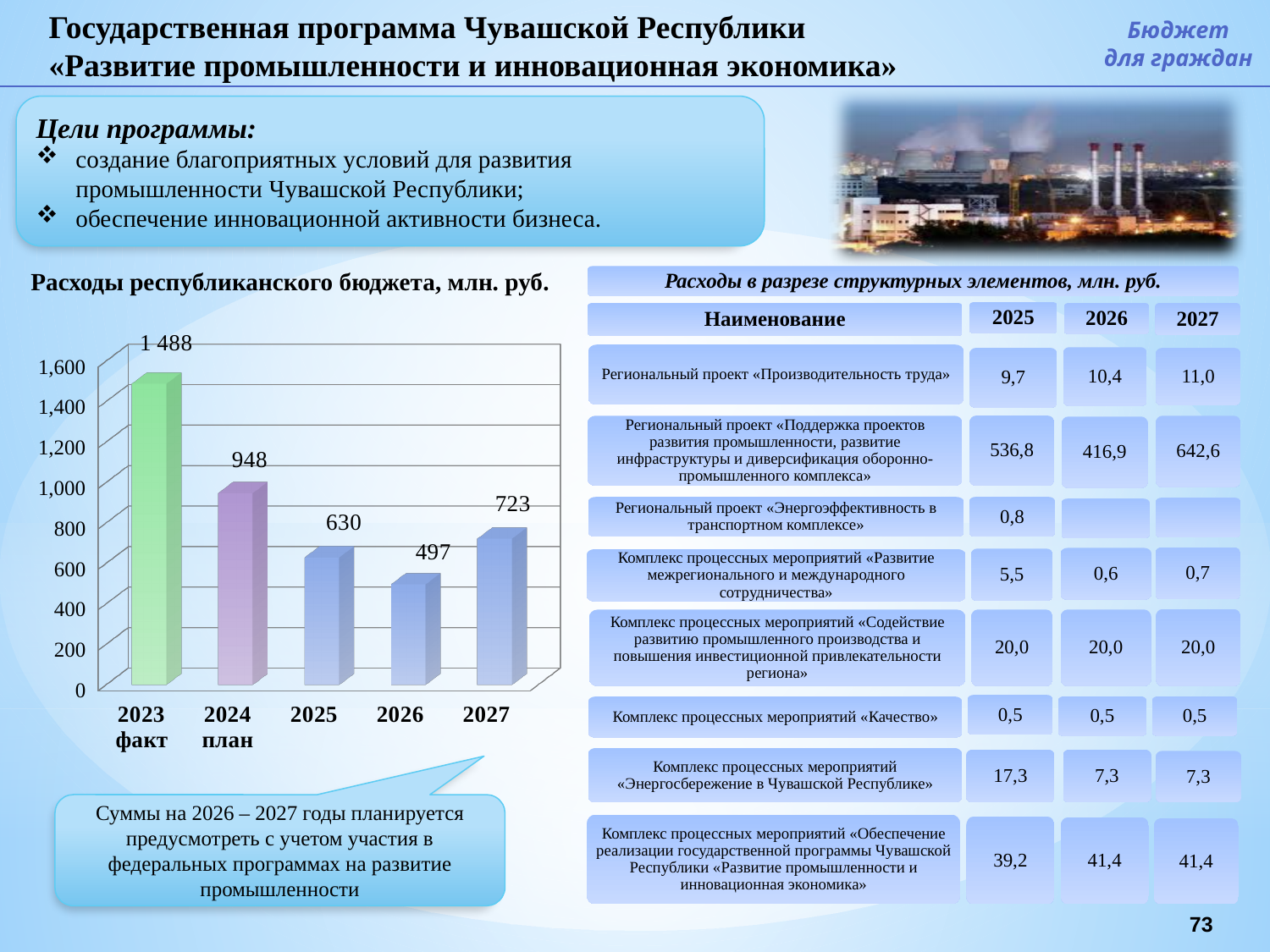
What is the value for 2027 in the chart? 723 What is the value for 2024 план in the chart? 948 Which year has the lowest value in the chart? 2026 Which is larger, the value for 2025 or the value for 2027? 2027 What is the value for 2025 in the chart? 630 Which year has the highest value in the chart? 2023 факт What is the title of the chart on the slide? Расходы республиканского бюджета, млн. руб. What kind of chart is shown on the slide? bar chart How many bars are shown in the chart? 5 What is the difference between the values for 2027 and 2026? 226 What is the value for 2023 факт in the chart 'Расходы республиканского бюджета, млн. руб.'? 1 488 What is the difference between the values for 2023 факт and 2024 план? 540